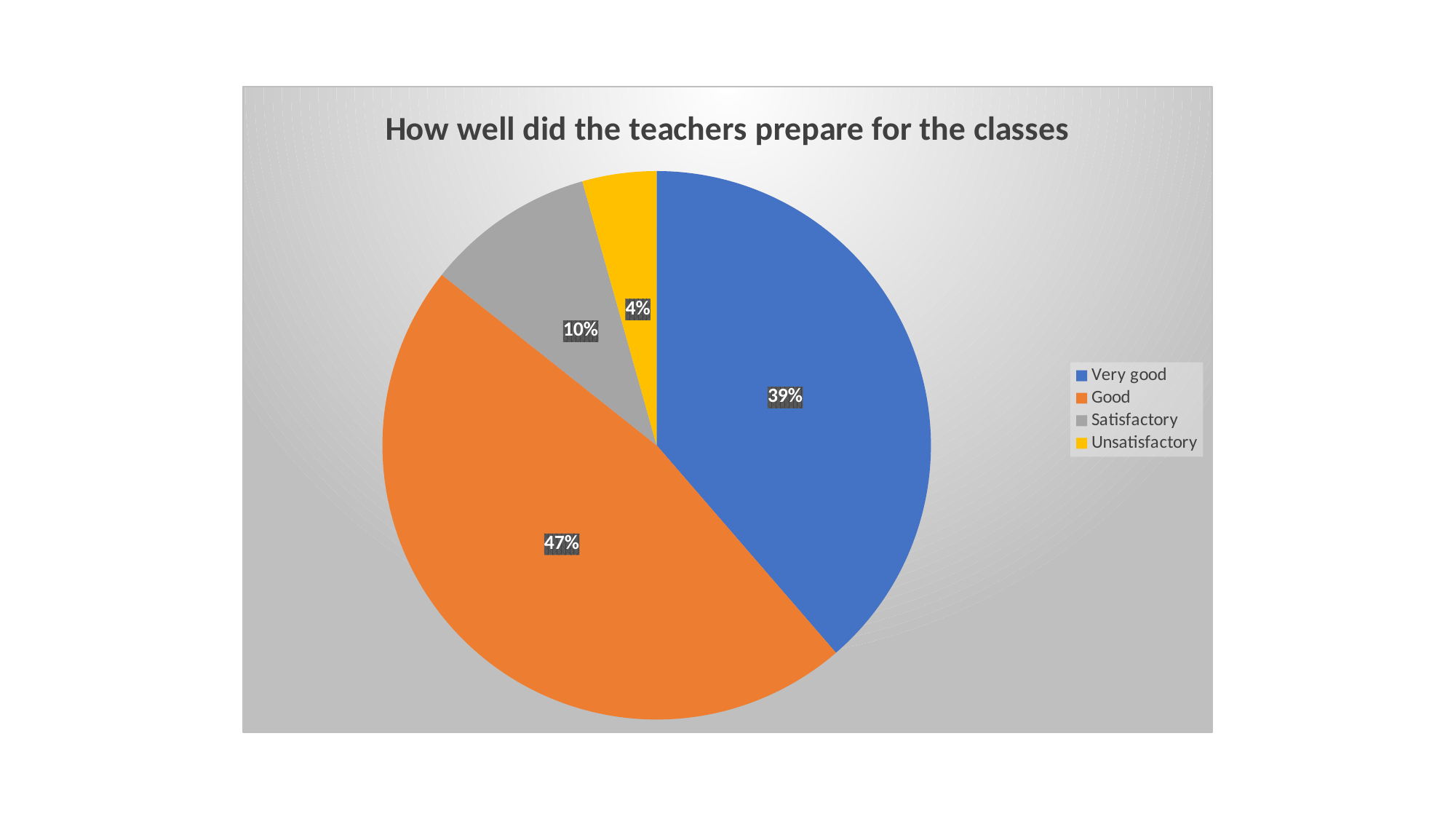
What share of the pie does the Unsatisfactory slice represent? 4% What share of the pie does the Very good slice represent? 39% How many categories are shown in the pie chart? 4 Which category has the smallest slice of the pie? Unsatisfactory What share of the pie does the Satisfactory slice represent? 10% What is the difference in percentage points between the Satisfactory and Unsatisfactory slices? 6 Which slice is larger, Very good or Satisfactory? Very good What is the difference in percentage points between the Good and Very good slices? 8 What kind of chart is shown on the slide? Pie chart Which category has the largest slice of the pie? Good What is the title of the chart? How well did the teachers prepare for the classes